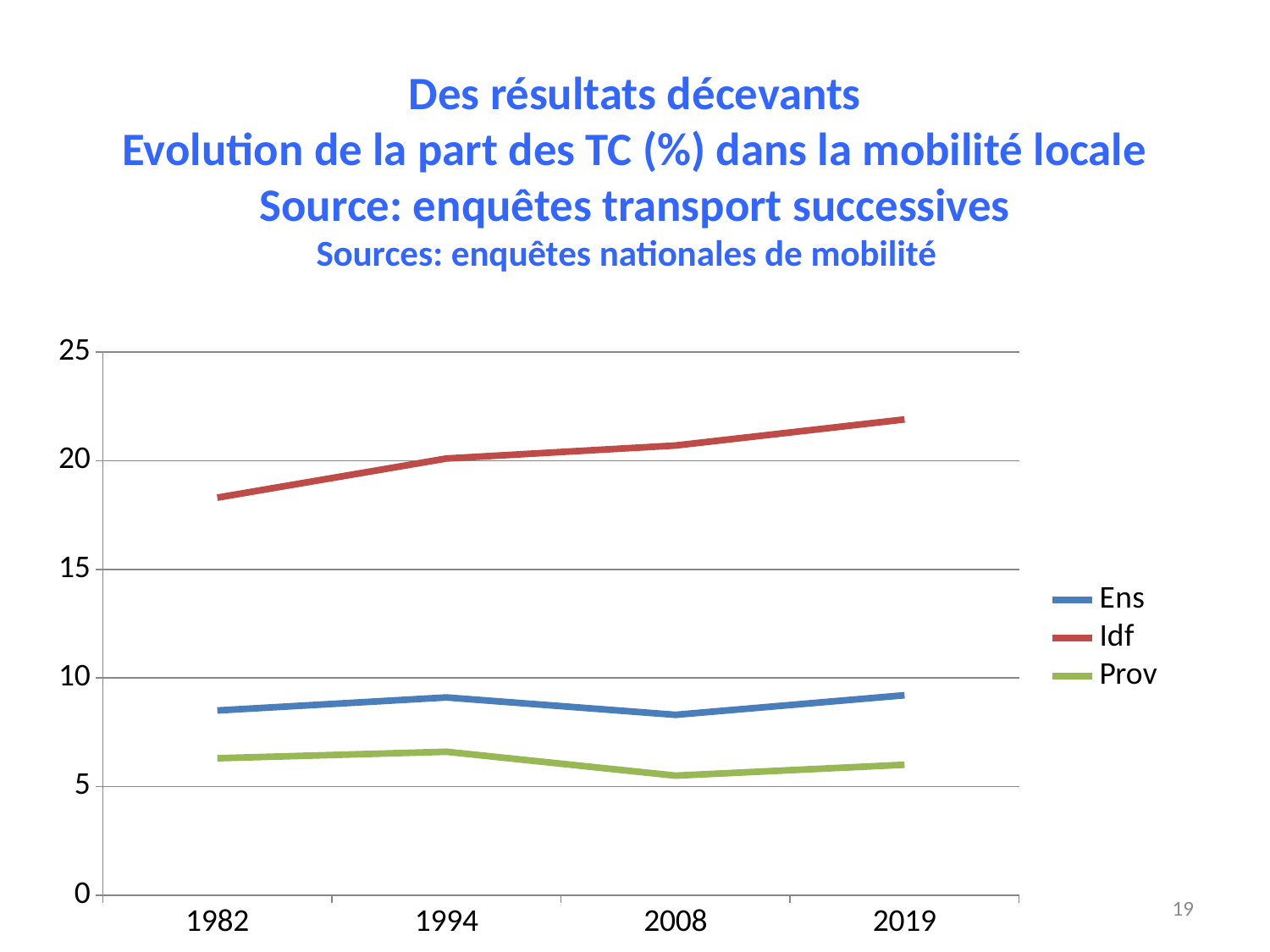
Does the Idf line rise or fall from 1982 to 2019? rise Is the value for Idf in 2019 greater or less than 20? greater Is the value for Ens in 2008 greater or less than 10? less Which series has the highest values across all years? Idf What are the years shown on the x axis? 1982, 1994, 2008, 2019 How many points along the x axis does each line have? 4 Which is larger in 2008, the value for Ens or the value for Prov? Ens Which series has the lowest values across all years? Prov What kind of chart is shown on the slide? line chart Is the value for Prov in 1994 greater or less than 5? greater How many series does the legend list? 3